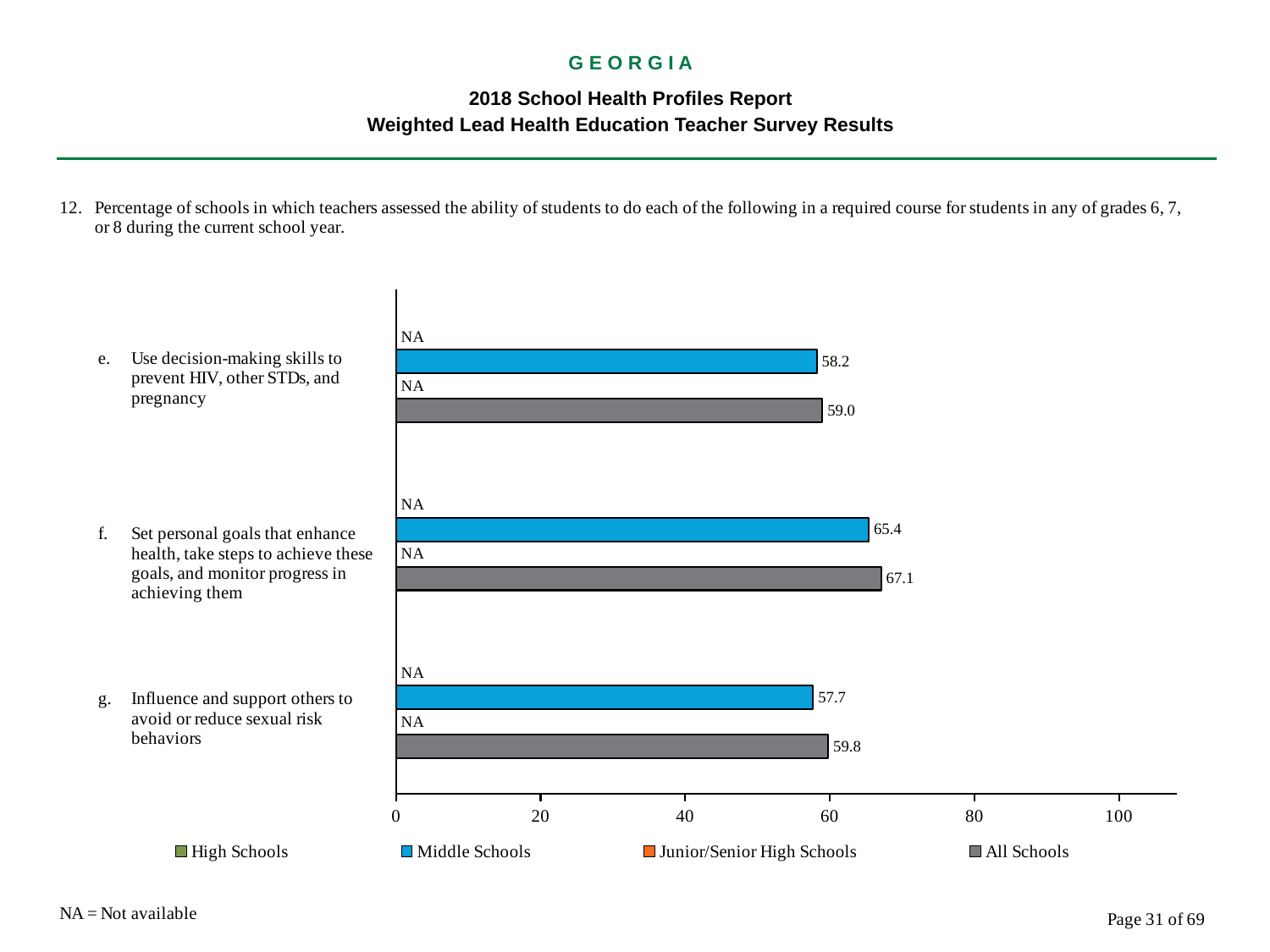
What kind of chart is shown on the slide? Bar chart What is the difference between the All Schools and Middle Schools values for item f? 1.7 Which item has the lowest All Schools value? e. Use decision-making skills to prevent HIV, other STDs, and pregnancy Which item has the highest Middle Schools value? f. Set personal goals that enhance health, take steps to achieve these goals, and monitor progress in achieving them What is the Middle Schools value for item e, 'Use decision-making skills to prevent HIV, other STDs, and pregnancy'? 58.2 What is the Middle Schools value for item g, 'Influence and support others to avoid or reduce sexual risk behaviors'? 57.7 Is the Middle Schools value for item f greater or less than 60? greater Which is larger for item g: the Middle Schools value or the All Schools value? All Schools What value is shown for High Schools and Junior/Senior High Schools for each item? NA What is the All Schools value for item g, 'Influence and support others to avoid or reduce sexual risk behaviors'? 59.8 What is the All Schools value for item f, 'Set personal goals that enhance health, take steps to achieve these goals, and monitor progress in achieving them'? 67.1 How many series does the legend list? 4